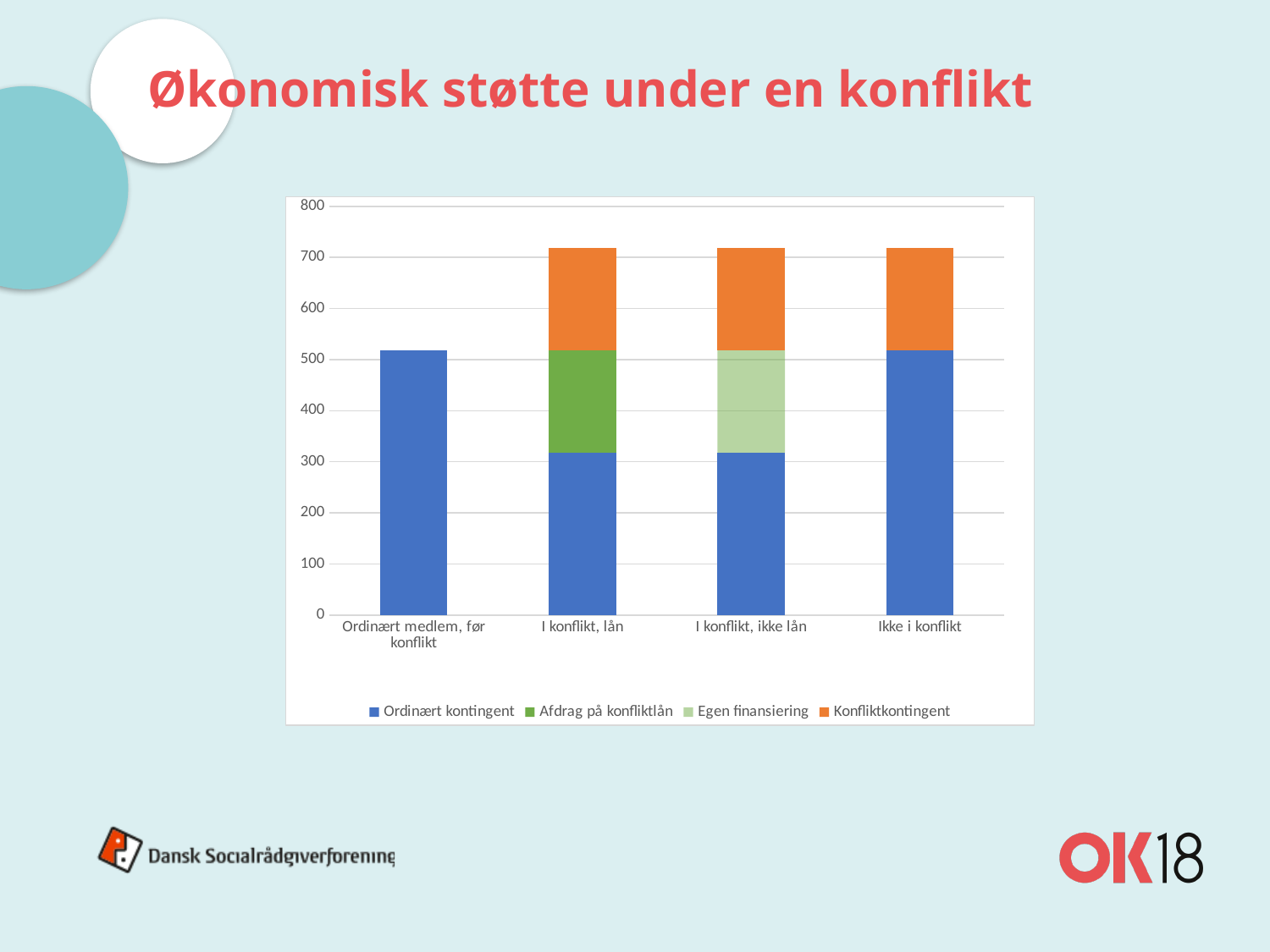
Is the total bar for 'Ordinært medlem, før konflikt' greater or less than 600? less Which has the larger total bar: 'Ordinært medlem, før konflikt' or 'I konflikt, ikke lån'? I konflikt, ikke lån What is the title of the slide containing the chart? Økonomisk støtte under en konflikt How many categories are shown on the x axis of the chart? 4 Is the 'Ordinært kontingent' segment for 'I konflikt, lån' greater or less than 400? less How many series does the chart legend list? 4 What kind of chart is shown on the slide? Stacked bar chart Which series appears only in the 'I konflikt, ikke lån' bar? Egen finansiering Is the total bar for 'I konflikt, lån' greater or less than 600? greater Which category has the lowest total bar height? Ordinært medlem, før konflikt